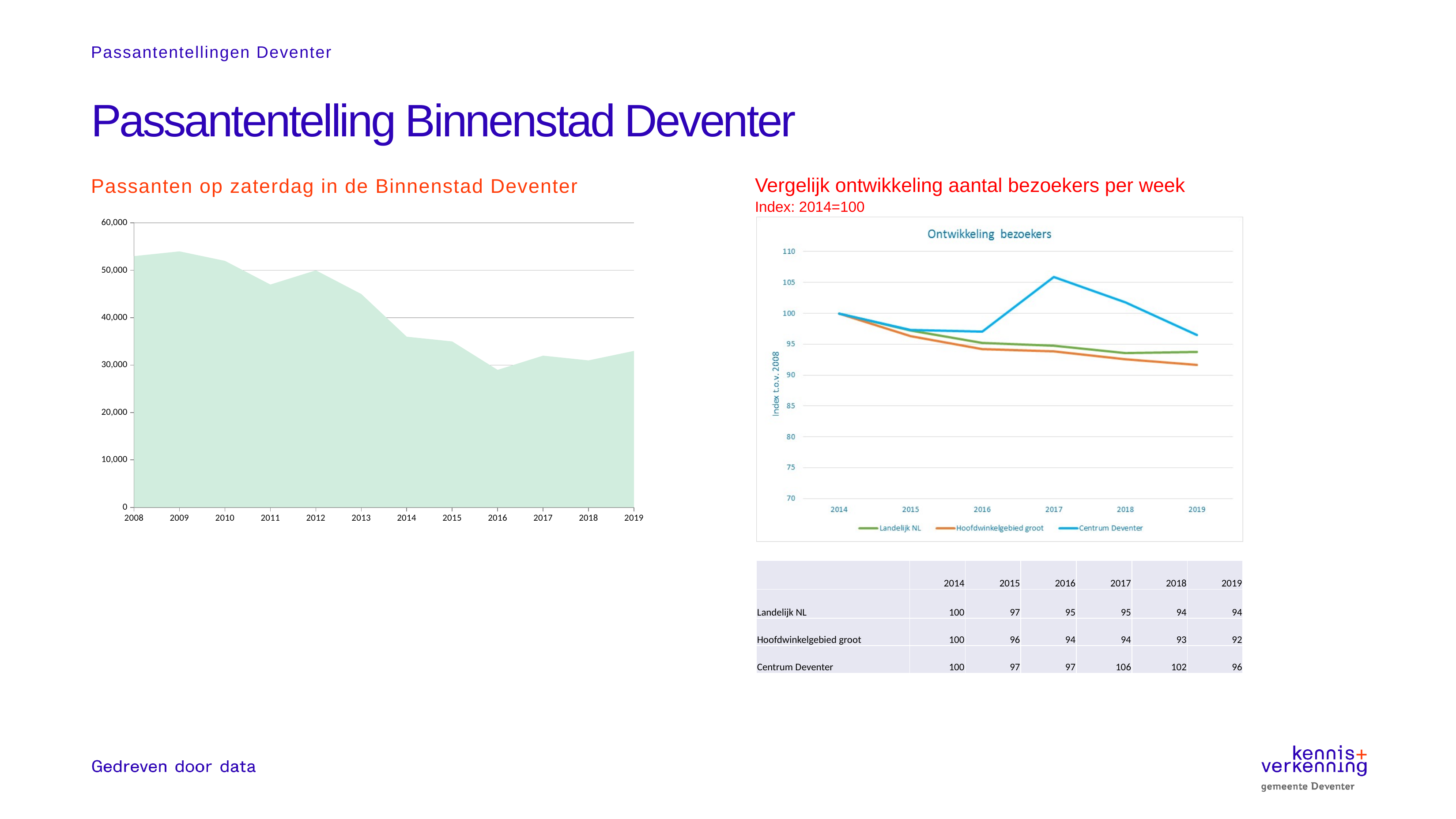
In the right chart 'Ontwikkeling bezoekers', what is the difference between Centrum Deventer and Landelijk NL in 2017? 11 What kind of chart is the left chart, 'Passanten op zaterdag in de Binnenstad Deventer'? area chart In the left chart 'Passanten op zaterdag in de Binnenstad Deventer', which year has the lowest value? 2016 In the right chart 'Ontwikkeling bezoekers', how many series does the legend list? 3 In the right chart 'Ontwikkeling bezoekers', which series has the highest value in 2017? Centrum Deventer What kind of chart is the right chart, 'Ontwikkeling bezoekers'? line chart In the left chart 'Passanten op zaterdag in de Binnenstad Deventer', is the value for 2014 greater or less than 40,000? less In the left chart 'Passanten op zaterdag in de Binnenstad Deventer', is the value for 2008 greater or less than 50,000? greater In the left chart 'Passanten op zaterdag in de Binnenstad Deventer', do the values generally rise or fall from 2008 to 2019? fall In the left chart 'Passanten op zaterdag in de Binnenstad Deventer', how many years are shown on the x axis? 12 In the right chart 'Ontwikkeling bezoekers', what is the index value for Centrum Deventer in 2017? 106 In the right chart 'Ontwikkeling bezoekers', what is the index value for Hoofdwinkelgebied groot in 2019? 92